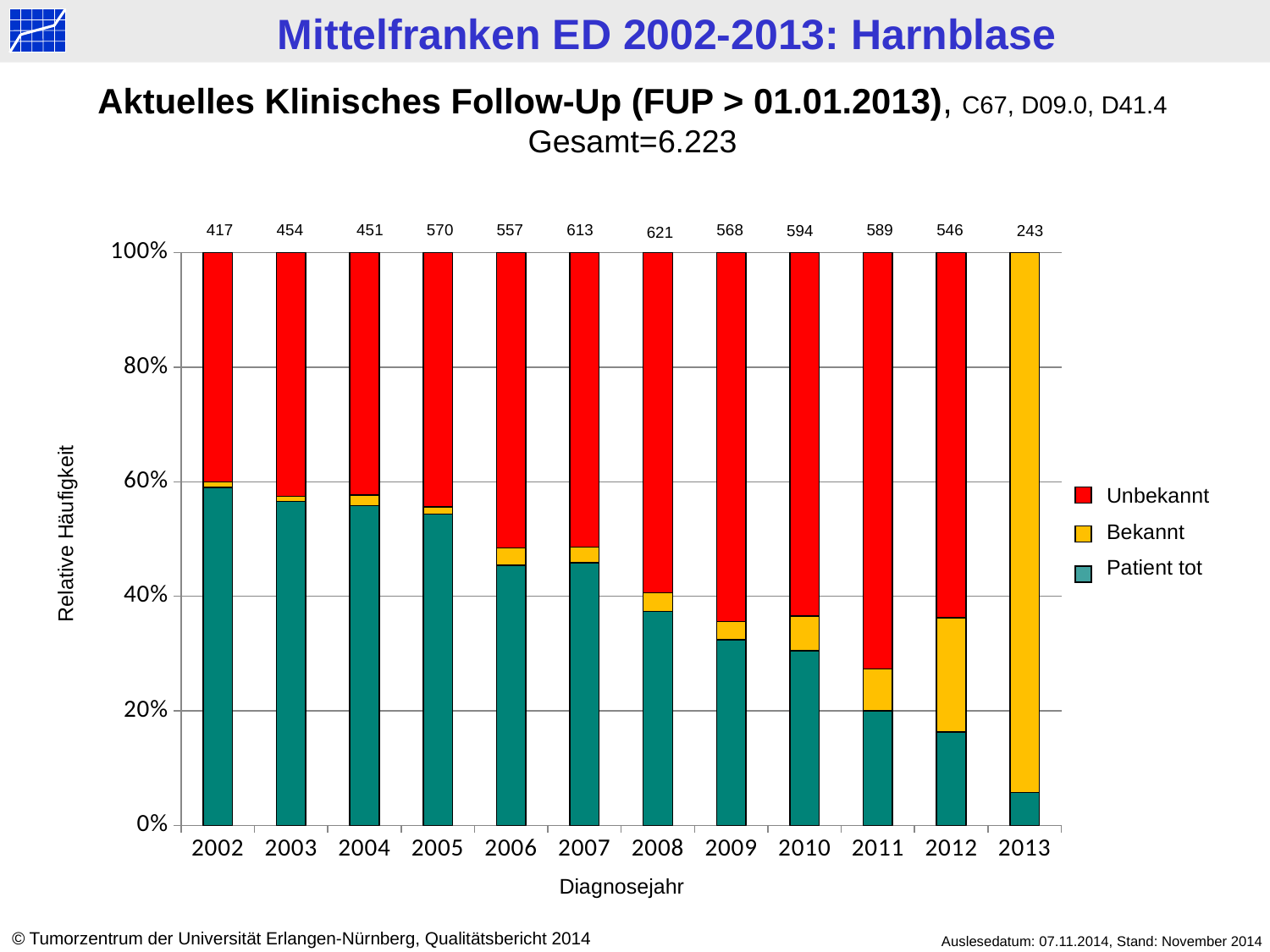
What number is printed above the bar for 2013? 243 Which year has the lowest number printed above its bar? 2013 Is the share of 'Patient tot' in 2002 greater or less than 40%? greater What number is printed above the bar for 2002? 417 Which year has the larger number printed above its bar, 2006 or 2007? 2007 What is the difference between the numbers printed above the bars for 2007 and 2013? 370 What number is printed above the bar for 2007? 613 Is the share of 'Patient tot' in 2013 greater or less than 20%? less Which year has the highest number printed above its bar? 2008 How many series does the legend list? 3 How many years are shown on the x axis? 12 Does the share of 'Patient tot' rise or fall from 2002 to 2013? fall